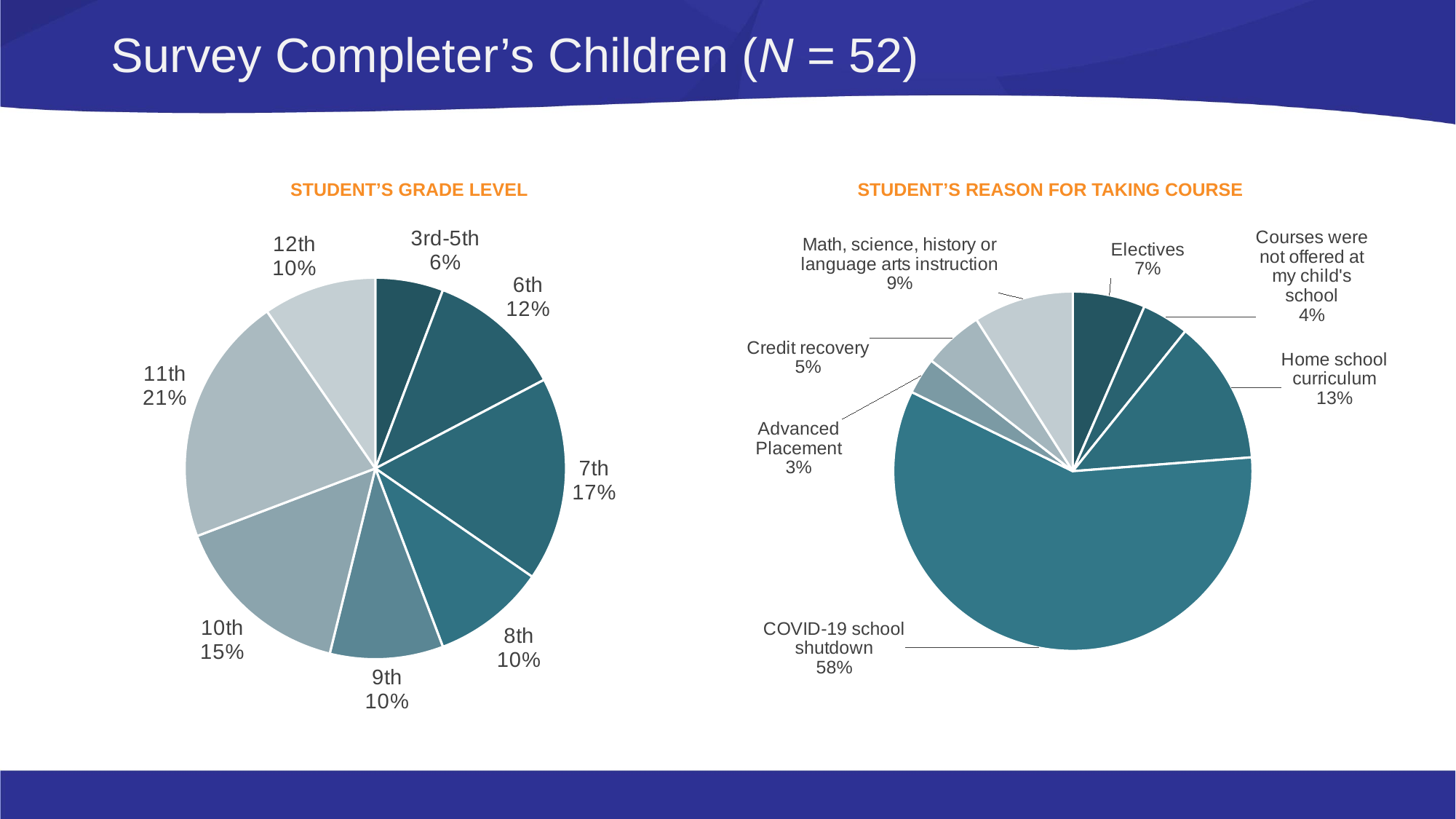
In the "Student's Grade Level" chart, which is larger, the share for 10th grade or the share for 8th grade? 10th In the "Student's Grade Level" chart, what share of students are in 11th grade? 21% In the "Student's Grade Level" chart, which grade level has the largest share? 11th In the "Student's Reason for Taking Course" chart, how many reasons are shown? 7 In the "Student's Reason for Taking Course" chart, what is the share for Home school curriculum? 13% In the "Student's Grade Level" chart, how many grade-level categories are shown? 8 In the "Student's Reason for Taking Course" chart, which reason has the smallest share? Advanced Placement What type of chart is used for "Student's Reason for Taking Course"? Pie chart In the "Student's Reason for Taking Course" chart, what share of students took the course because of the COVID-19 school shutdown? 58% In the "Student's Grade Level" chart, which grade level has the smallest share? 3rd-5th What is the title of the slide? Survey Completer's Children (N = 52) In the "Student's Grade Level" chart, what is the difference in percentage points between 7th grade and 6th grade? 5 percentage points